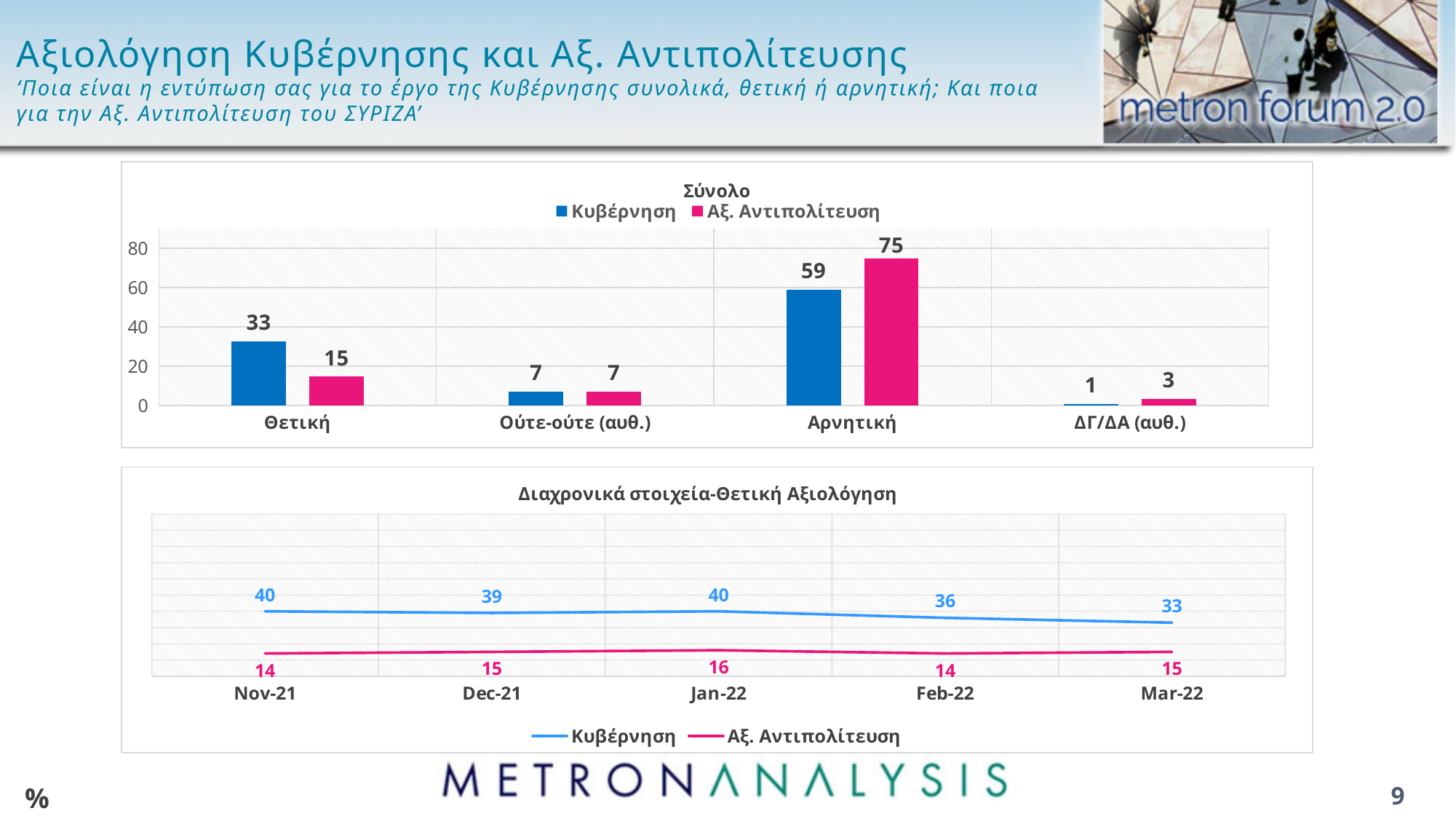
In the 'Σύνολο' chart, what is the value for Αξ. Αντιπολίτευση in the Θετική category? 15 In the 'Σύνολο' chart, what is the difference between Αξ. Αντιπολίτευση and Κυβέρνηση in the Αρνητική category? 16 In the 'Σύνολο' chart, what is the value for Κυβέρνηση in the Αρνητική category? 59 In the 'Σύνολο' chart, which category has the highest value for Αξ. Αντιπολίτευση? Αρνητική In the 'Διαχρονικά στοιχεία-Θετική Αξιολόγηση' chart, does the Κυβέρνηση line rise or fall from Jan-22 to Mar-22? Fall In the 'Διαχρονικά στοιχεία-Θετική Αξιολόγηση' chart, what is the value for Αξ. Αντιπολίτευση in Jan-22? 16 In the 'Σύνολο' chart, how many categories are shown on the x axis? 4 In the 'Διαχρονικά στοιχεία-Θετική Αξιολόγηση' chart, what is the value for Κυβέρνηση in Feb-22? 36 How many series does the legend of the 'Διαχρονικά στοιχεία-Θετική Αξιολόγηση' chart list? 2 In the 'Σύνολο' chart, which category has the lowest value for Κυβέρνηση? ΔΓ/ΔΑ (αυθ.) What kind of chart is the 'Σύνολο' chart? Bar chart In the 'Σύνολο' chart, which series has the larger value in the Θετική category? Κυβέρνηση